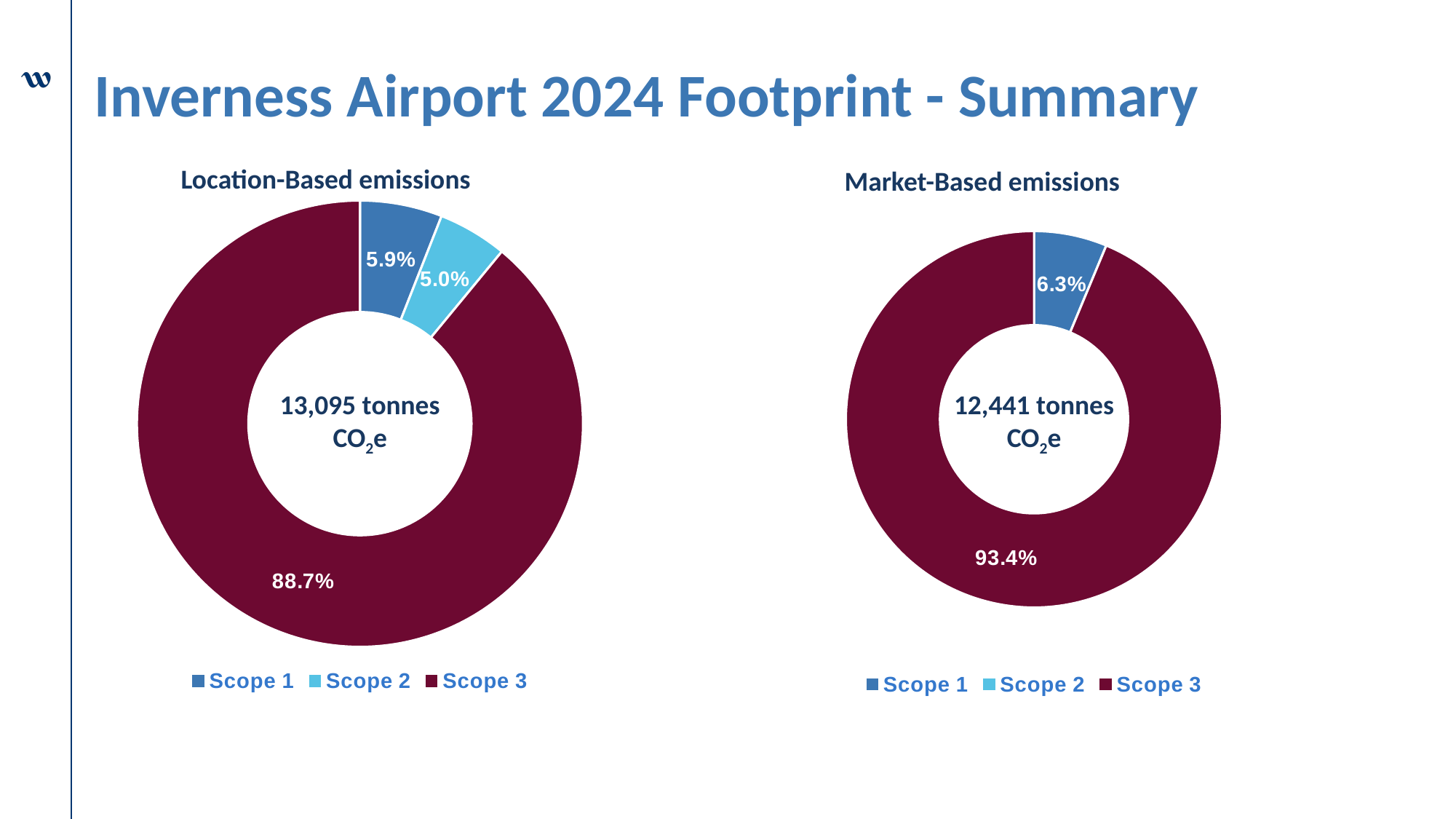
How many scopes does the legend of the Market-Based emissions chart list? 3 In the Location-Based emissions chart, what share of emissions is Scope 1? 5.9% In the Location-Based emissions chart, what share of emissions is Scope 3? 88.7% In the Location-Based emissions chart, what is the difference in percentage points between the Scope 1 and Scope 2 shares? 0.9 percentage points In the Location-Based emissions chart, what share of emissions is Scope 2? 5.0% What kind of chart is the Location-Based emissions chart? Donut (pie) chart Is the Scope 3 share larger in the Location-Based emissions chart or the Market-Based emissions chart? Market-Based emissions In the Location-Based emissions chart, which scope has the largest share? Scope 3 What total is shown in the centre of the Market-Based emissions chart? 12,441 tonnes CO2e In the Location-Based emissions chart, which scope has the smallest share? Scope 2